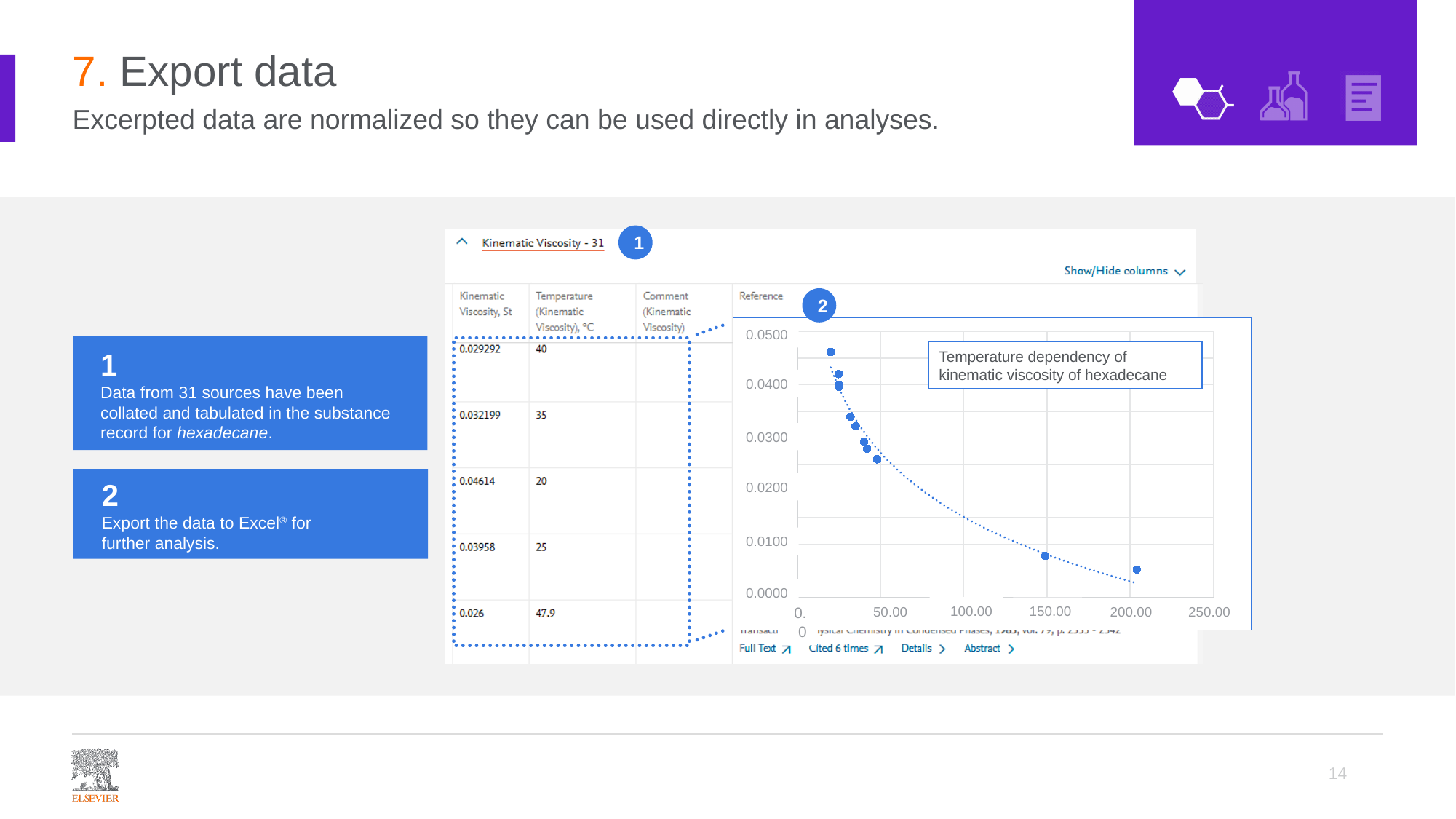
Is the kinematic viscosity value plotted at about 50 °C greater or less than 0.0300? less Which is larger: the kinematic viscosity plotted at about 20 °C or at about 200 °C? about 20 °C What is the highest value shown on the x axis of the chart? 250.00 Is the kinematic viscosity value plotted at about 200 °C greater or less than 0.0100? less Is the lowest plotted kinematic viscosity value greater or less than 0.0100? less Do the plotted values rise or fall as temperature increases along the x axis? fall What kind of chart is shown on the slide? scatter chart What is the title of the chart on the slide? Temperature dependency of kinematic viscosity of hexadecane